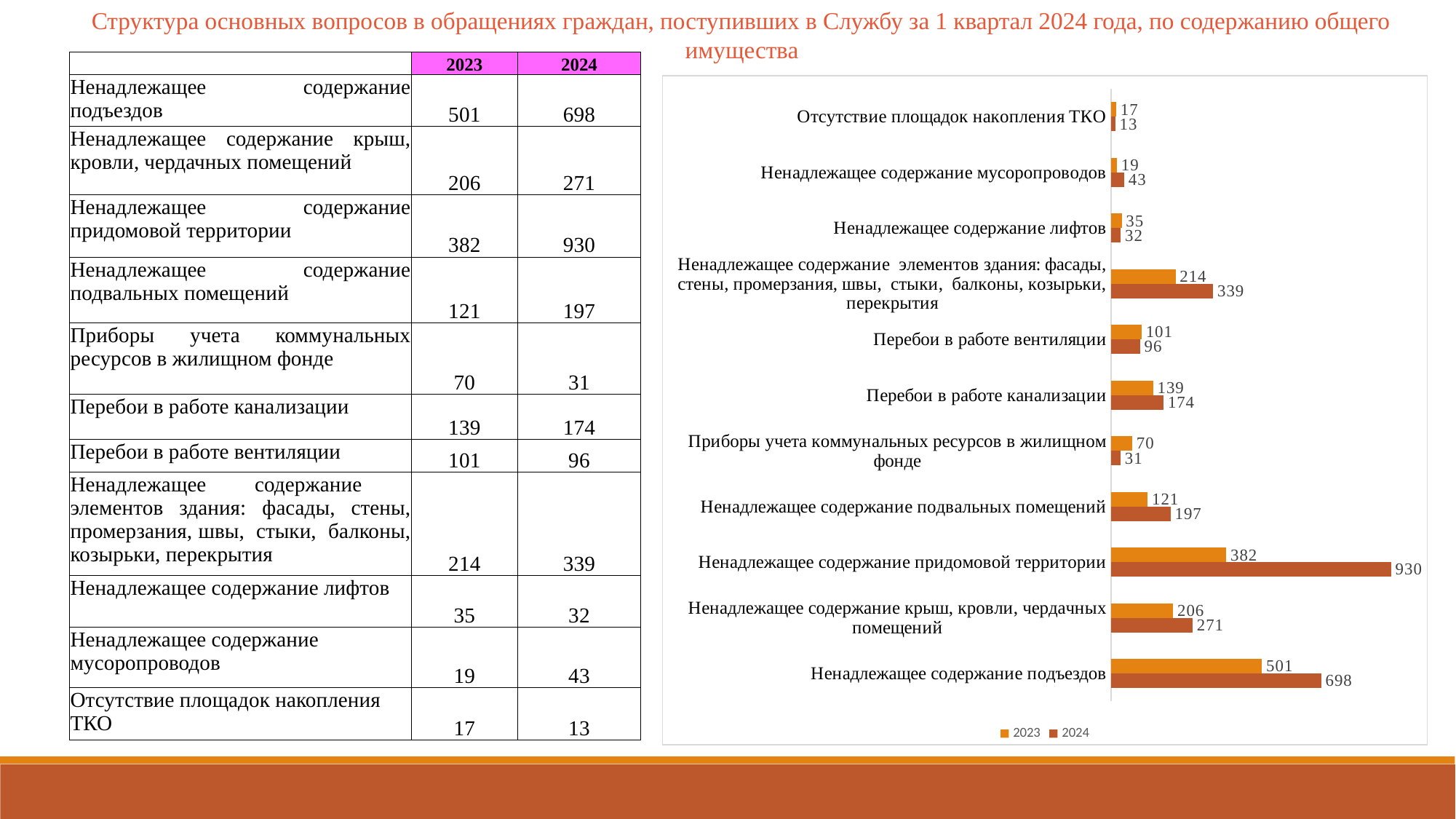
How many categories are plotted in the chart? 11 Which category has the highest 2024 value? Ненадлежащее содержание придомовой территории What is the difference between the 2024 and 2023 values for "Ненадлежащее содержание подъездов"? 197 What type of chart is shown on the slide? bar chart Which series is shown in the darker red-brown colour in the chart? 2024 For "Приборы учета коммунальных ресурсов в жилищном фонде", which year has the larger value, 2023 or 2024? 2023 What is the 2024 value for "Ненадлежащее содержание мусоропроводов"? 43 Which category has the lowest 2024 value? Отсутствие площадок накопления ТКО For "Перебои в работе вентиляции", which year has the larger value, 2023 or 2024? 2023 How many series does the chart legend list? 2 What is the 2024 value for "Ненадлежащее содержание придомовой территории"? 930 What is the 2023 value for "Перебои в работе канализации"? 139